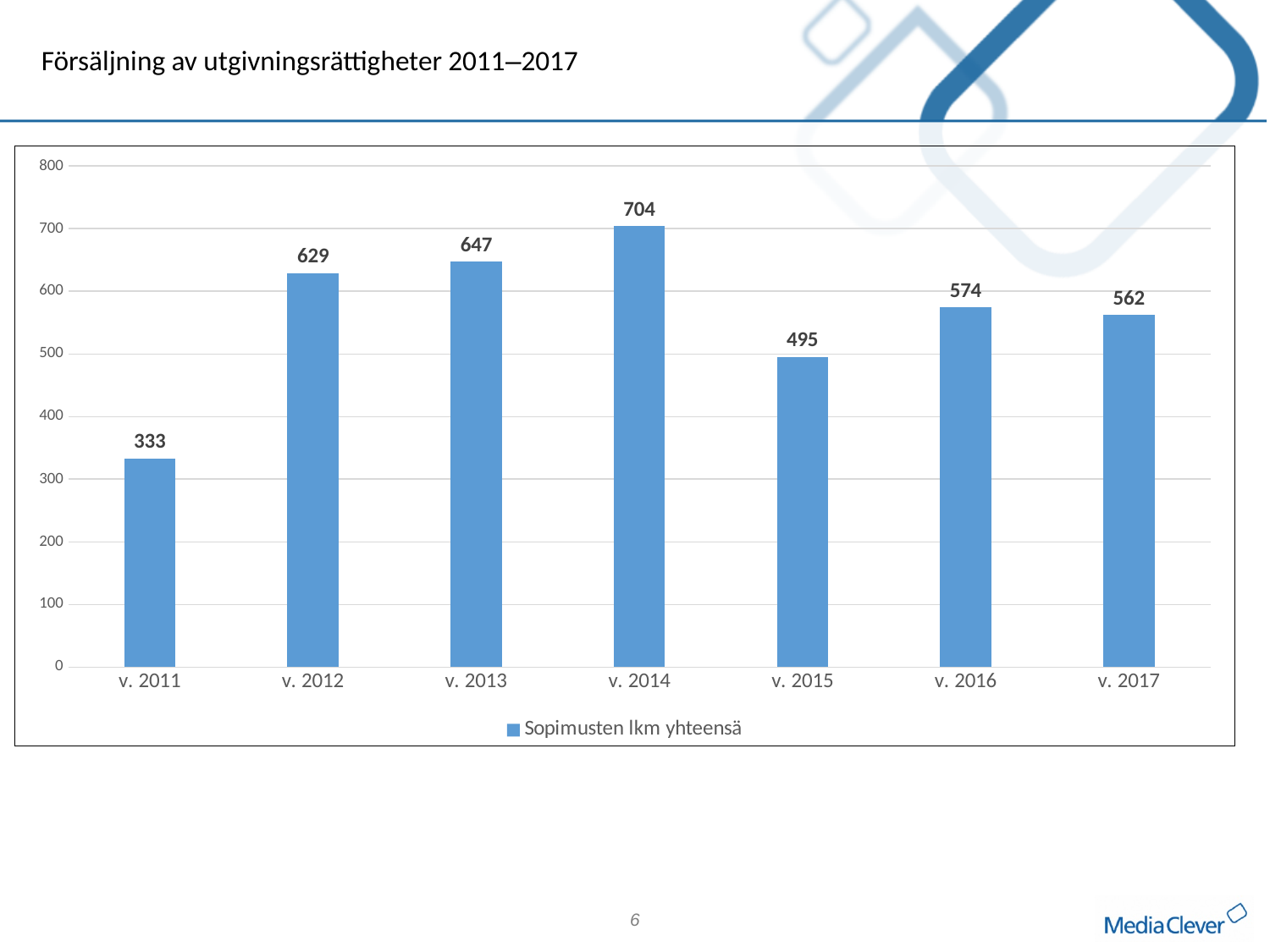
Which is larger, the value for v. 2013 or the value for v. 2016? v. 2013 Is the value for v. 2015 greater or less than 500? less What is the difference between the values for v. 2014 and v. 2015? 209 Which year has the lowest value? v. 2011 What is the difference between the values for v. 2012 and v. 2011? 296 What kind of chart is shown on the slide? bar chart Which year has the highest value? v. 2014 What is the value for v. 2014? 704 What is the legend entry for the series? Sopimusten lkm yhteensä What is the value for v. 2017? 562 How many years are shown on the x axis? 7 What is the value for v. 2011? 333